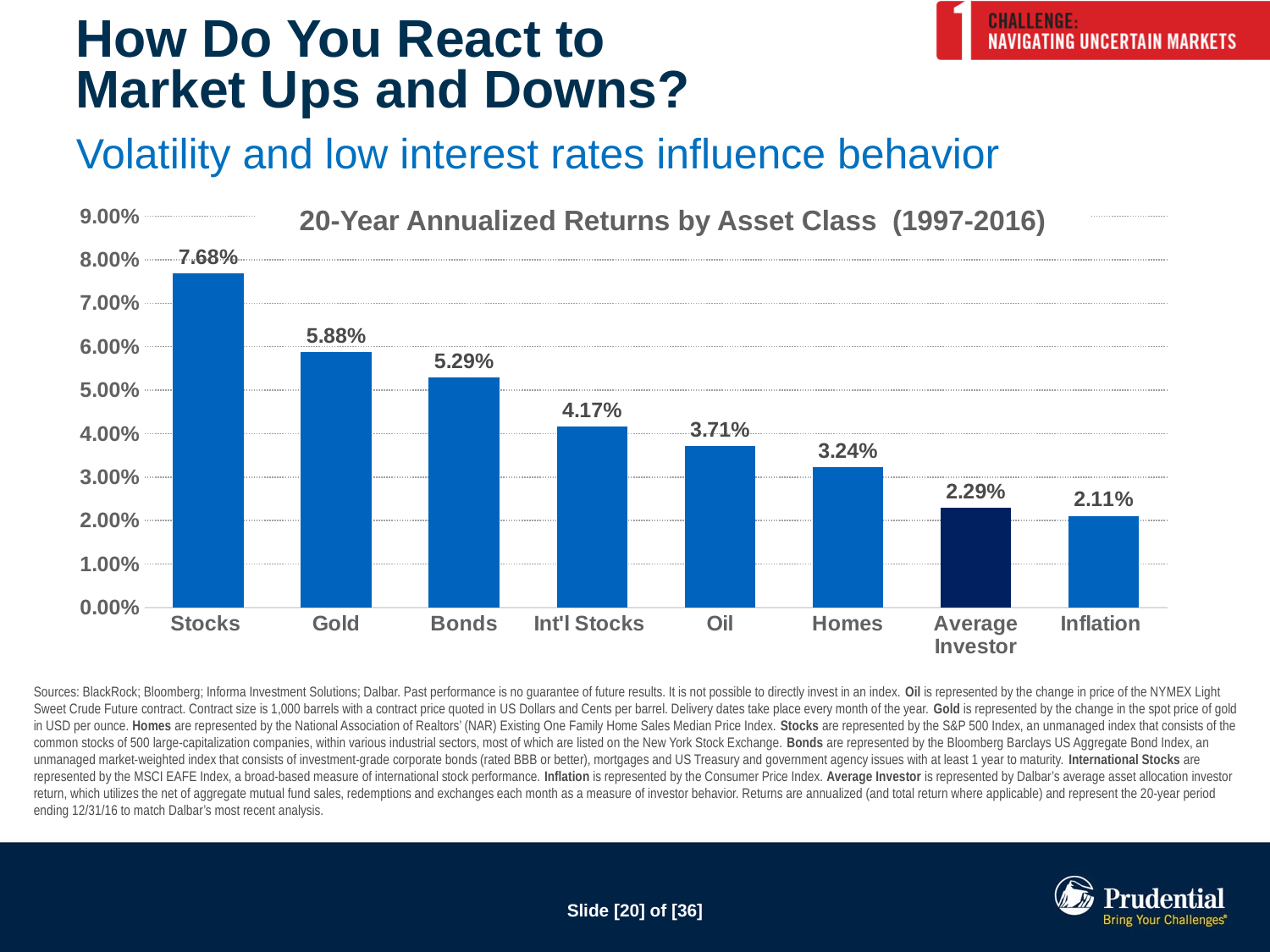
What is the difference between the returns for Stocks and the Average Investor? 5.39% Do the values rise or fall moving from left to right across the chart? Fall What kind of chart is shown on the slide? Bar chart What is the 20-year annualized return for Stocks? 7.68% What is the value shown for Gold? 5.88% Which category has the lowest value on the chart? Inflation How many asset classes are shown on the chart? 8 Which has a higher 20-year annualized return, Bonds or Oil? Bonds Is the value for Homes greater or less than 3.00%? greater What is the title of the chart? 20-Year Annualized Returns by Asset Class (1997-2016) Which asset class has the highest 20-year annualized return? Stocks What is the 20-year annualized return for the Average Investor? 2.29%